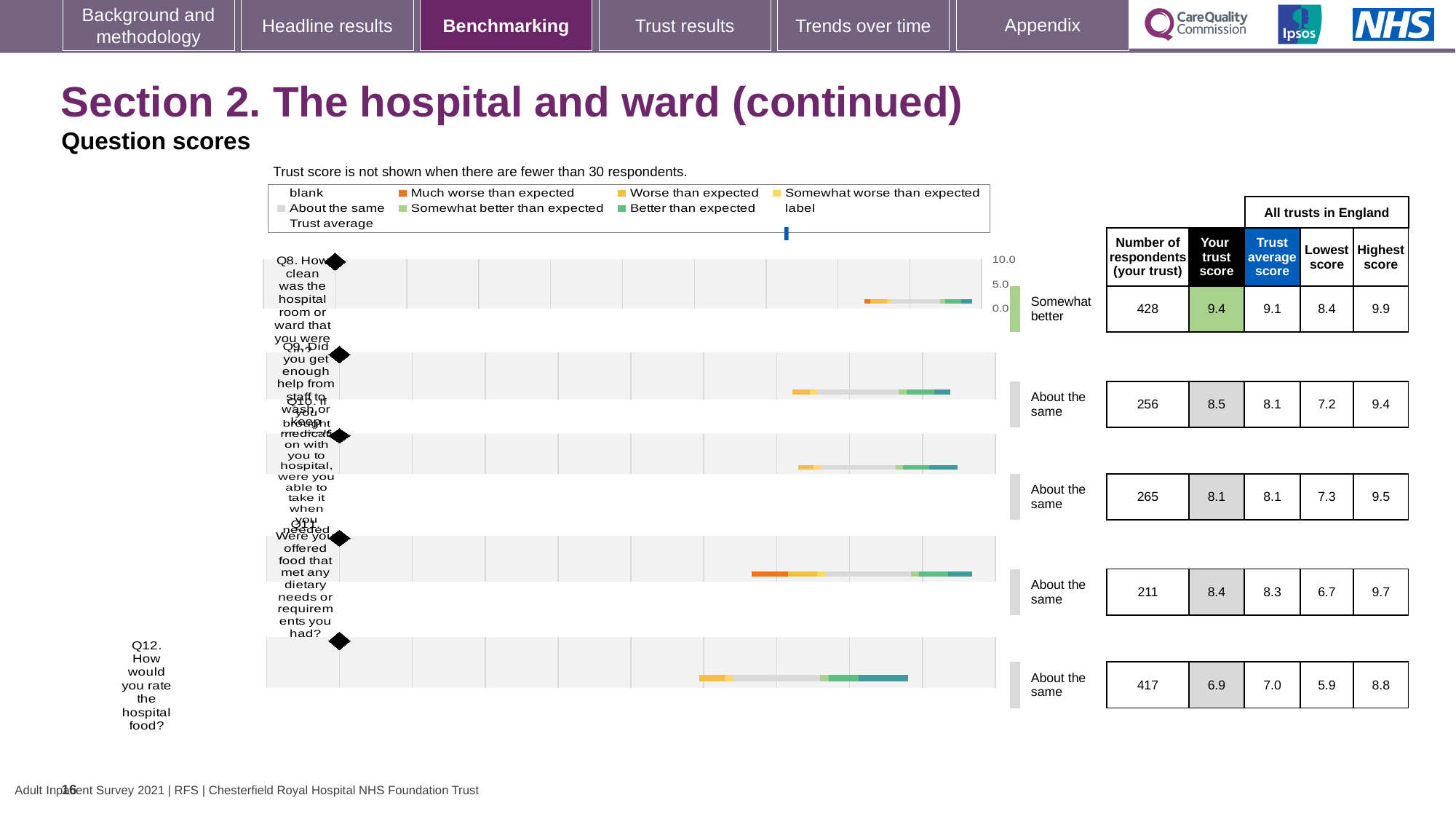
What benchmark category is shown for Q8? Somewhat better For Q9, which is larger: your trust score or the trust average score? Your trust score How many respondents from your trust answered Q12 (How would you rate the hospital food)? 417 What is the trust average score for Q10? 8.1 What is the 'Your trust score' for Q8 (How clean was the hospital room or ward)? 9.4 Which question has the highest 'Your trust score'? Q8 What is the difference between the trust score and the trust average score for Q8? 0.3 Which question has the lowest 'Your trust score'? Q12 What kind of chart is used to show the question scores? Bar chart How many questions are plotted on the chart? 5 What is the lowest score across all trusts in England for Q12? 5.9 What is the highest score across all trusts in England for Q11? 9.7